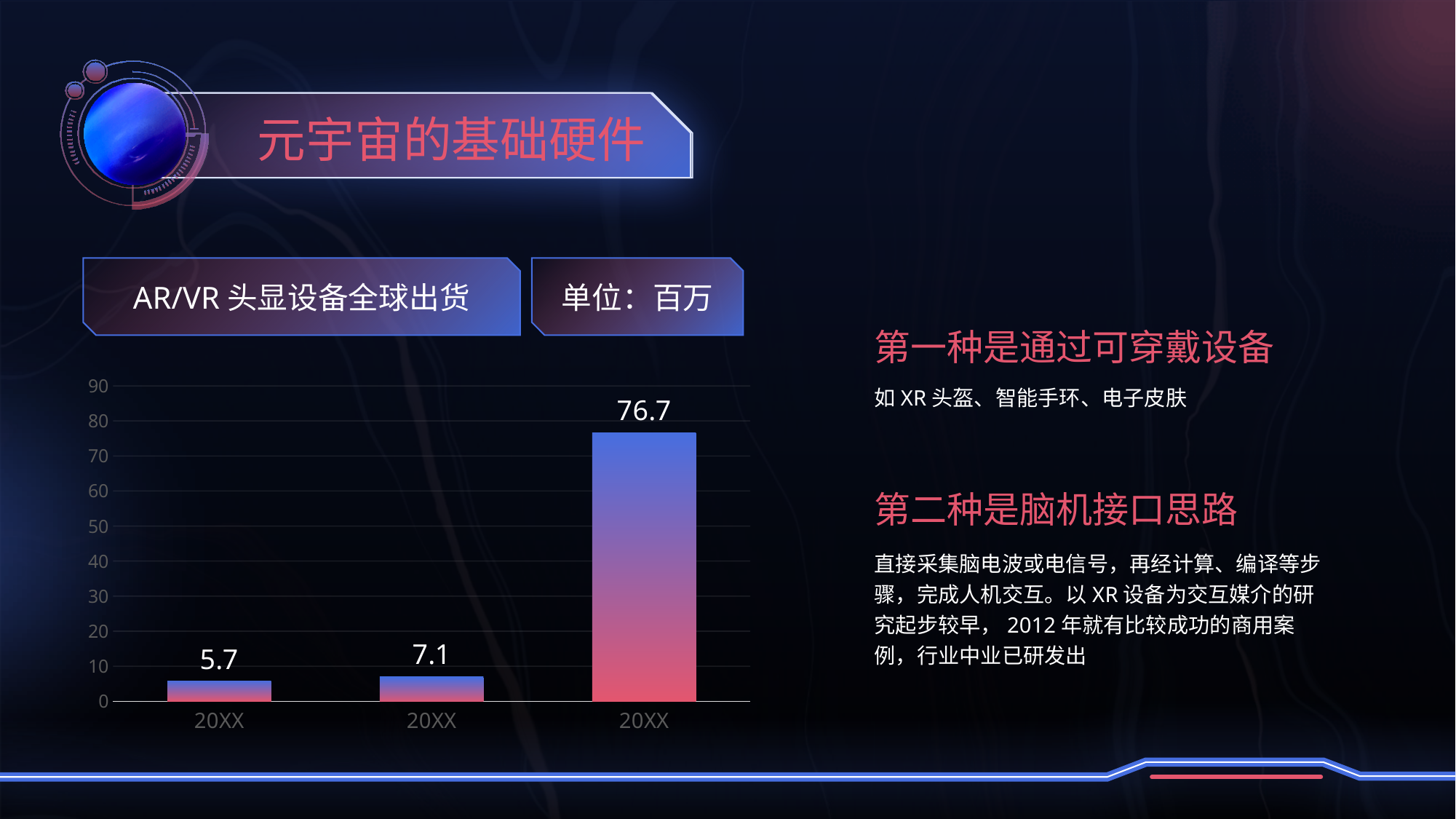
Which bar has the highest value? the third (rightmost) bar, 76.7 What is the value of the first (leftmost) bar? 5.7 What is the value of the second (middle) bar? 7.1 Which is larger, the first bar or the second bar? the second bar What is the value of the third (rightmost) bar? 76.7 Which bar has the lowest value? the first (leftmost) bar, 5.7 What is the difference between the second bar and the first bar? 1.4 What is the difference between the third bar and the second bar? 69.6 Do the values rise or fall from left to right along the x axis? rise What kind of chart is shown on the slide? bar chart How many bars are plotted in the chart? 3 What unit is stated for the chart values? 百万